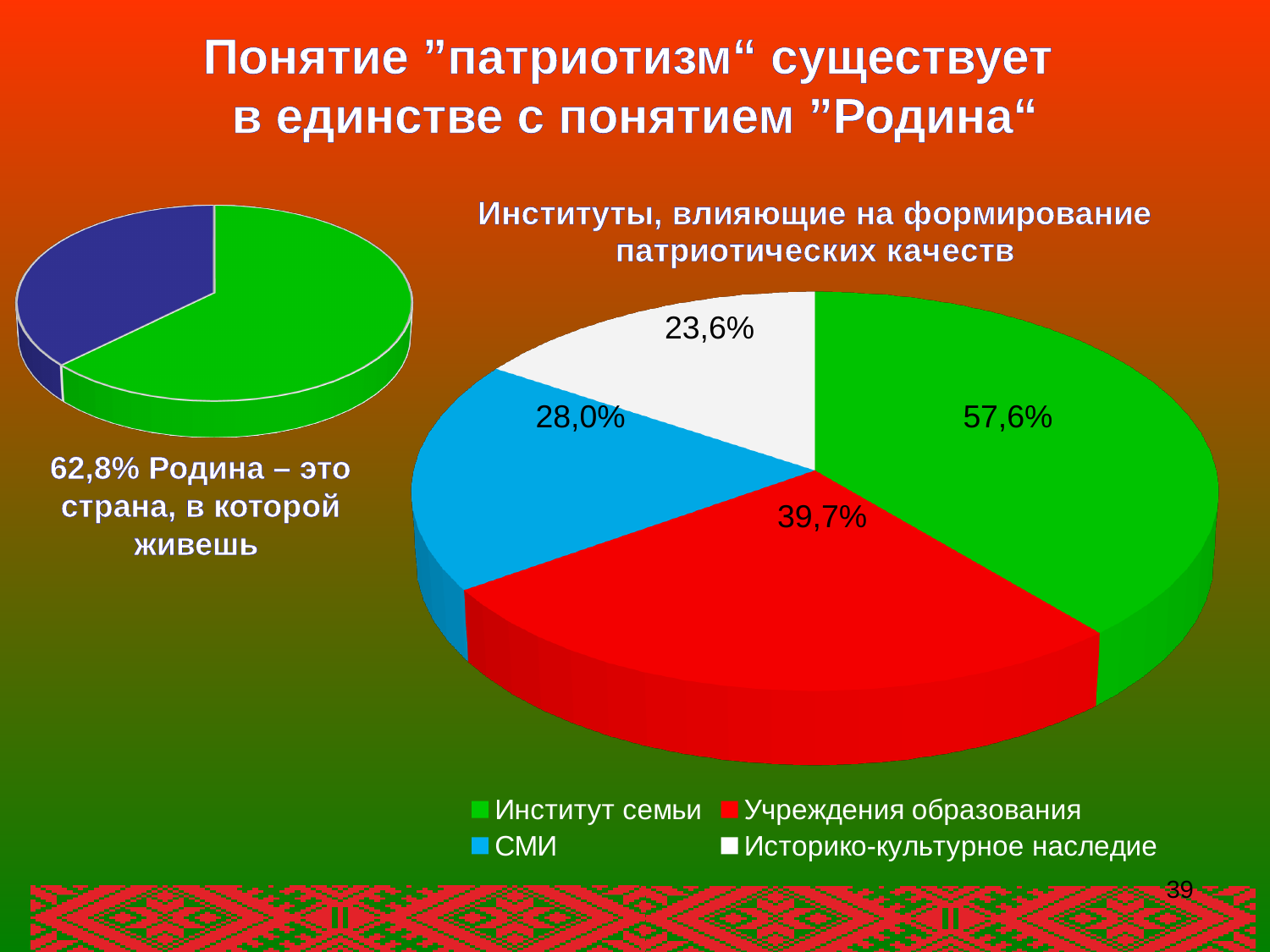
In the chart titled "Институты, влияющие на формирование патриотических качеств", which category has the highest value? Институт семьи In the chart titled "Институты, влияющие на формирование патриотических качеств", what is the value for Учреждения образования? 39,7% In the chart titled "Институты, влияющие на формирование патриотических качеств", which category has the lowest value? Историко-культурное наследие What kind of chart is the chart titled "Институты, влияющие на формирование патриотических качеств"? Pie chart In the chart titled "Институты, влияющие на формирование патриотических качеств", what is the value for Историко-культурное наследие? 23,6% In the chart titled "Институты, влияющие на формирование патриотических качеств", how many categories are shown? 4 In the pie chart on the left of the slide, which slice is larger: the green one or the blue one? The green one In the chart titled "Институты, влияющие на формирование патриотических качеств", what colour is the slice for Учреждения образования? Red In the chart titled "Институты, влияющие на формирование патриотических качеств", what is the difference between the values for Институт семьи and Учреждения образования? 17,9% In the chart titled "Институты, влияющие на формирование патриотических качеств", what is the value for СМИ? 28,0% In the chart titled "Институты, влияющие на формирование патриотических качеств", what is the value for Институт семьи? 57,6% In the chart titled "Институты, влияющие на формирование патриотических качеств", which is larger: СМИ or Историко-культурное наследие? СМИ